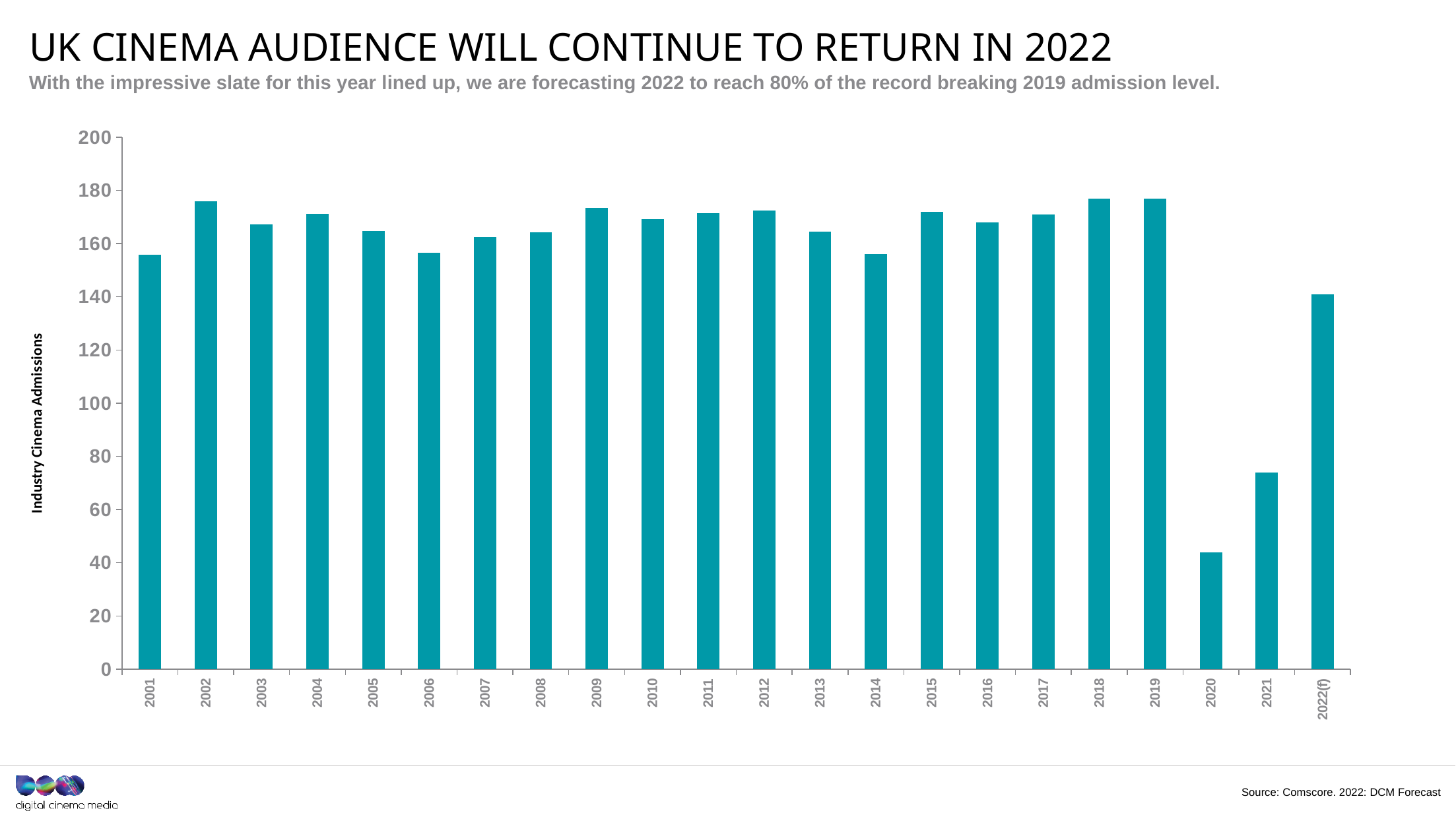
Is the value for 2022(f) greater or less than 120? greater Do the values rise or fall from 2020 to 2022(f)? rise Is the value for 2020 greater or less than 60? less Is the value for 2019 greater or less than 160? greater Which is larger, the value for 2019 or the value for 2022(f)? 2019 Which year has the lowest Industry Cinema Admissions? 2020 Which is larger, the value for 2020 or the value for 2021? 2021 What kind of chart is shown on the slide? bar chart How many years (bars) are plotted on the chart? 22 What is the label on the vertical axis of the chart? Industry Cinema Admissions